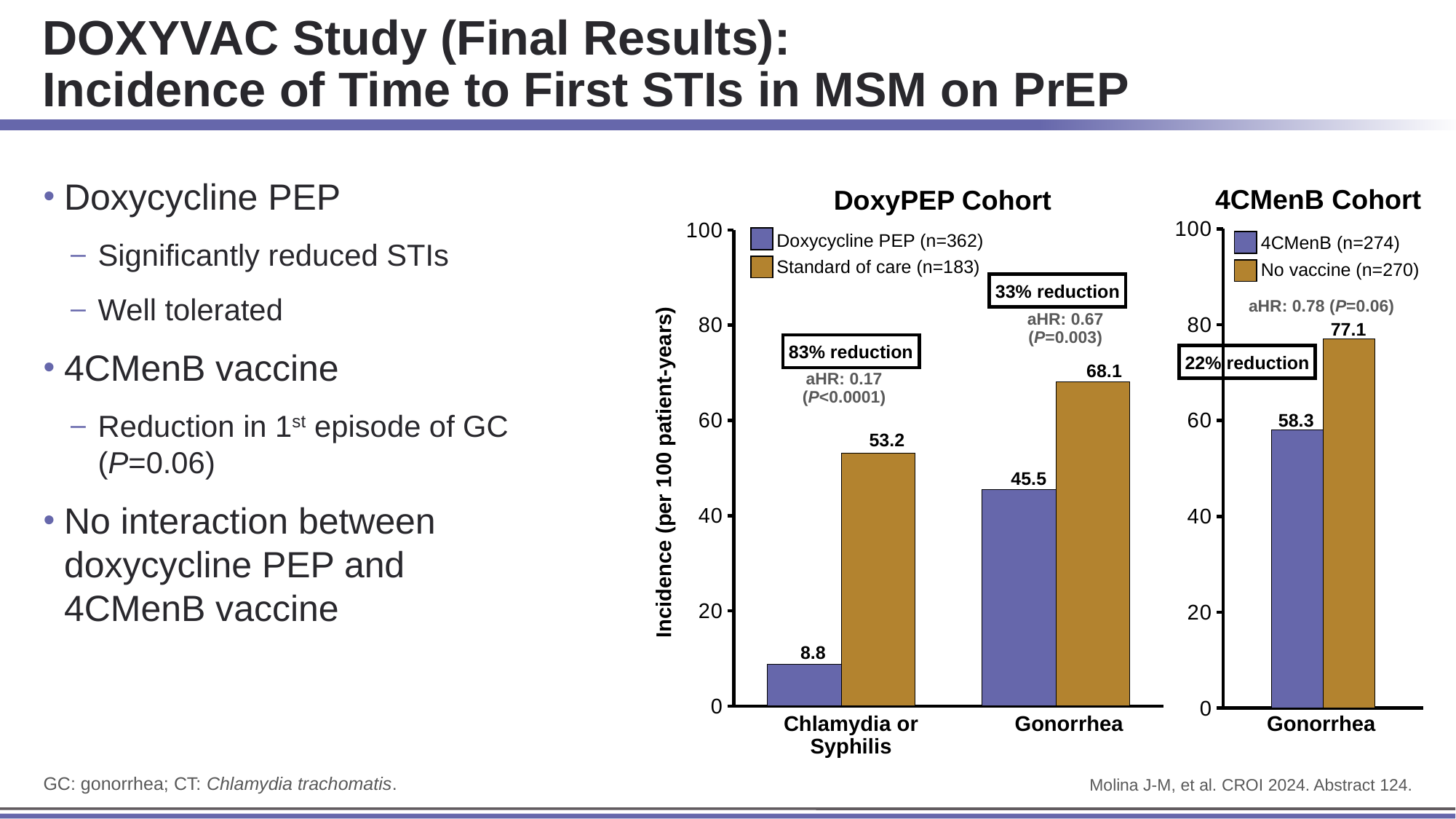
In the DoxyPEP Cohort chart, what is the difference between Standard of care and Doxycycline PEP for Chlamydia or Syphilis? 44.4 In the 4CMenB Cohort chart, what is the difference between No vaccine and 4CMenB for Gonorrhea? 18.8 In the 4CMenB Cohort chart, what is the incidence for 4CMenB? 58.3 What kind of chart is the 4CMenB Cohort chart? Bar chart In the DoxyPEP Cohort chart, what is the incidence for Doxycycline PEP in the Chlamydia or Syphilis category? 8.8 In the 4CMenB Cohort chart, what is the incidence for No vaccine? 77.1 How many categories are shown on the x axis of the DoxyPEP Cohort chart? 2 In the DoxyPEP Cohort chart, which is larger for Gonorrhea: Doxycycline PEP or Standard of care? Standard of care How many series does the legend of the DoxyPEP Cohort chart list? 2 In the DoxyPEP Cohort chart, which bar is the lowest? Doxycycline PEP, Chlamydia or Syphilis In the DoxyPEP Cohort chart, what is the incidence for Standard of care in the Gonorrhea category? 68.1 In the DoxyPEP Cohort chart, which bar is the highest? Standard of care, Gonorrhea